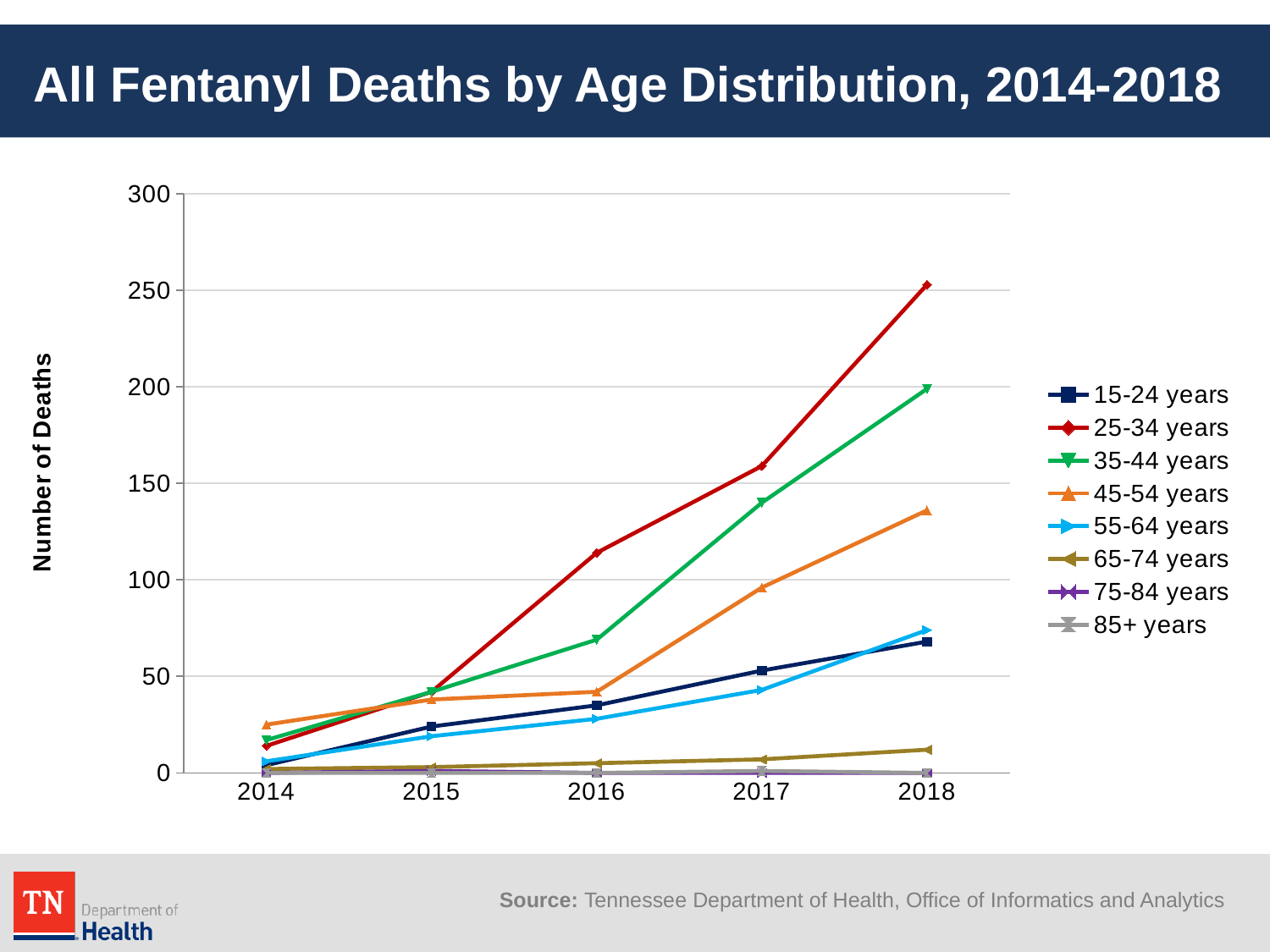
How many years are plotted along the x axis? 5 Is the value for 35-44 years in 2018 greater or less than 150? greater In 2018, which is larger: the value for 35-44 years or the value for 45-54 years? 35-44 years Which age group had the highest number of fentanyl deaths in 2018? 25-34 years What is the label on the y axis? Number of Deaths Is the value for 25-34 years in 2016 greater or less than 100? greater Is the value for 45-54 years in 2018 greater or less than 100? greater What kind of chart is shown on the slide? line chart Do the deaths for the 25-34 years group rise or fall from 2014 to 2018? rise How many series does the legend list? 8